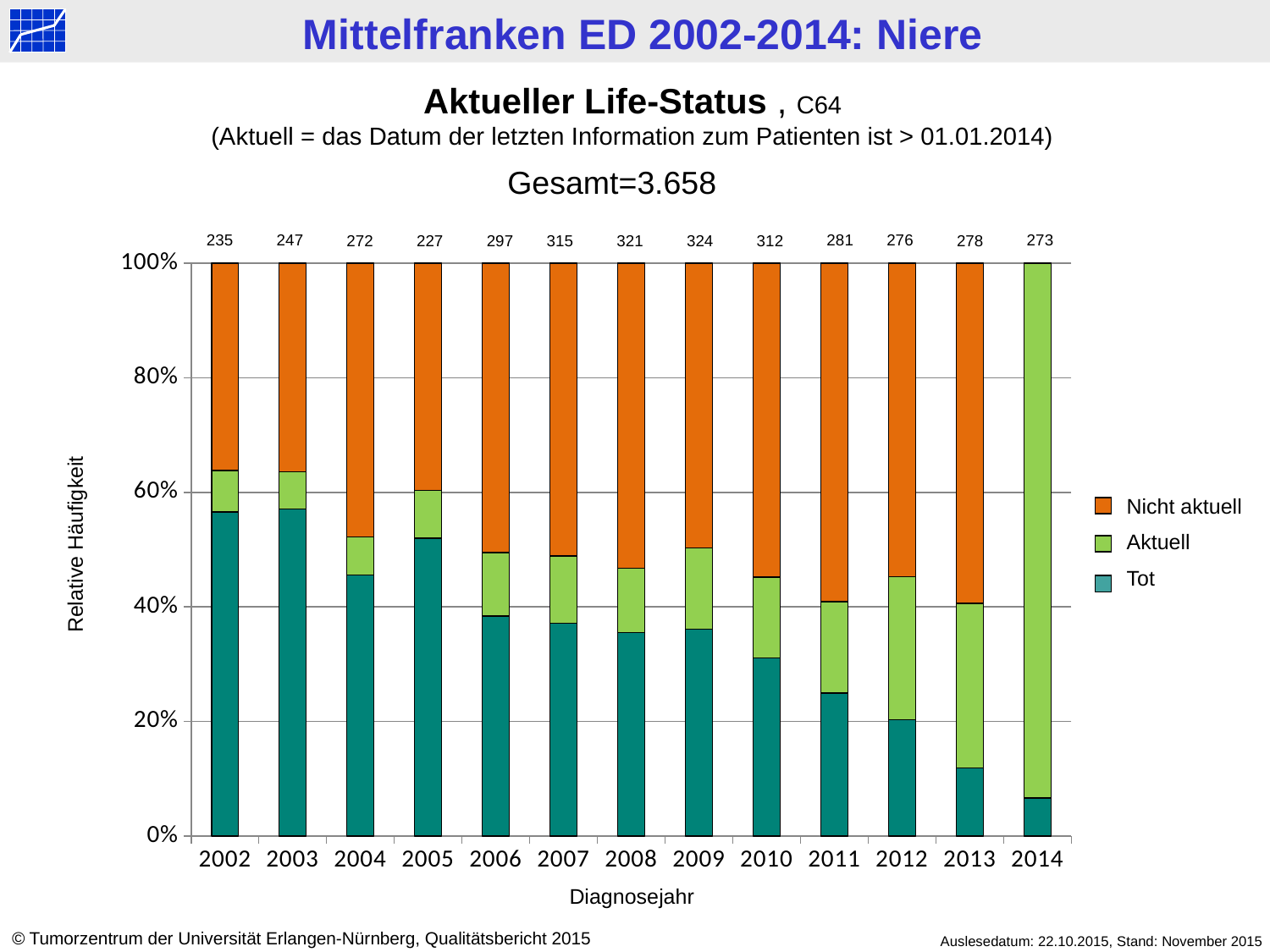
Which year has the larger case count printed above its bar, 2006 or 2007? 2007 How many diagnosis years are shown on the x axis? 13 What is the number of cases printed above the bar for 2002? 235 Which diagnosis year has the highest number of cases printed above its bar? 2009 Which diagnosis year has the lowest number of cases printed above its bar? 2005 How many series does the legend list? 3 What is the number of cases printed above the bar for 2014? 273 Is the share of 'Tot' in 2014 greater or less than 20%? less What is the difference between the case counts printed for 2009 and 2005? 97 What kind of chart is shown on the slide? Stacked bar chart Is the share of 'Tot' in 2002 greater or less than 40%? greater What is the number of cases printed above the bar for 2009? 324